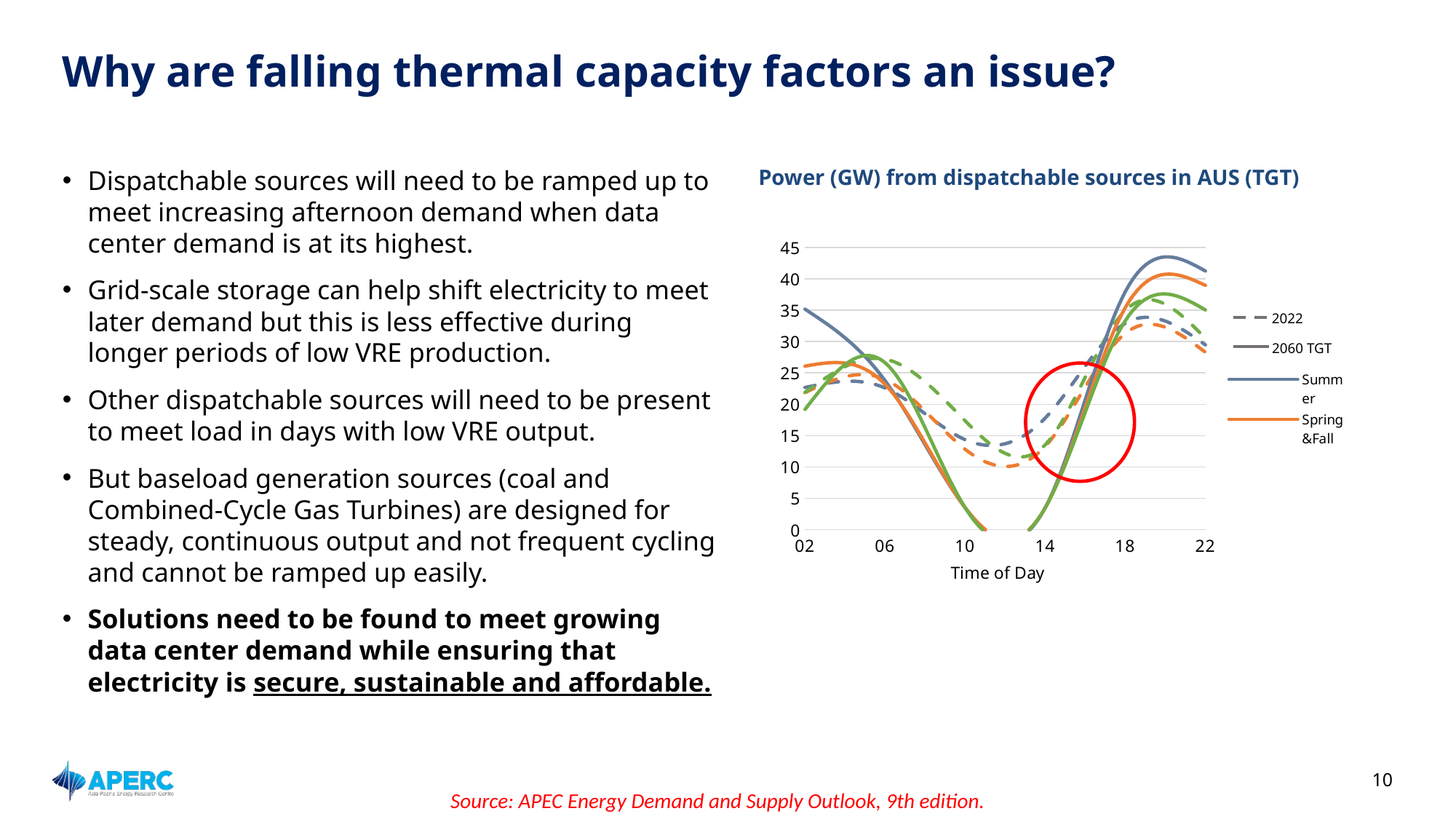
Do the solid 2060 TGT lines rise or fall between 06 and 10 on the x axis? fall What is the title of the chart? Power (GW) from dispatchable sources in AUS (TGT) Do the solid 2060 TGT lines rise or fall between 14 and 18 on the x axis? rise How many tick labels are shown on the x axis of the chart? 6 How many entries does the chart legend list? 4 What kind of chart is shown on the slide? line chart What is the label of the x axis of the chart? Time of Day Is the value of the solid Spring&Fall line at 02 greater or less than 20? greater Is the peak value of the solid Summer line greater or less than 40? greater Which series reaches the highest value on the chart? Summer (2060 TGT) Is the lowest value of the solid Summer line greater or less than 5? less